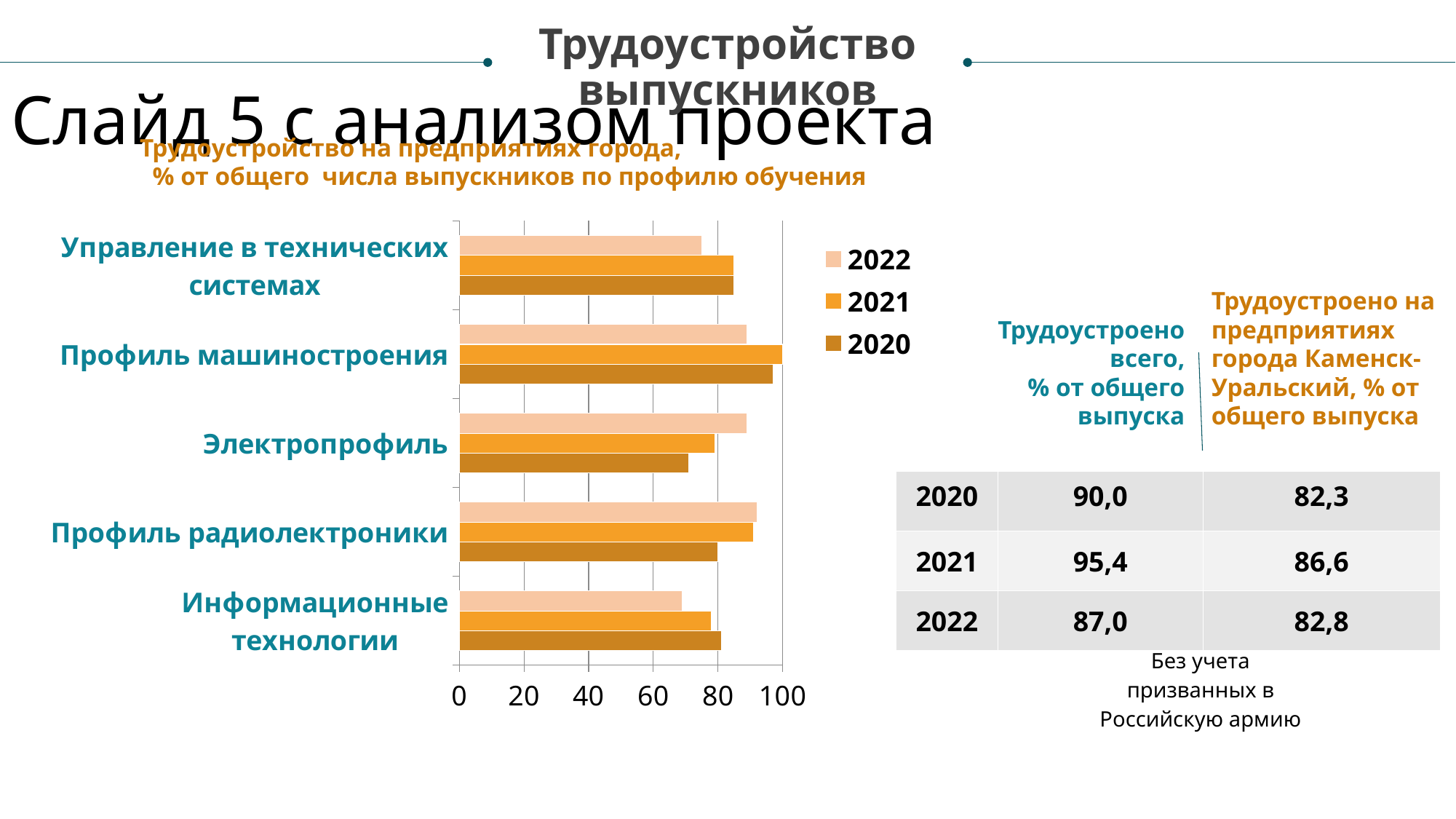
Is the 2021 value for Профиль машиностроения greater or less than 80? greater For Электропрофиль, which series has the larger value: 2022 or 2020? 2022 For Информационные технологии, which series has the larger value: 2020 or 2022? 2020 Is the 2022 value for Управление в технических системах greater or less than 80? less Which category has the lowest value for the 2022 series? Информационные технологии What kind of chart is shown on the slide? bar chart Which years are listed in the chart legend? 2022, 2021, 2020 Which category has the lowest value for the 2020 series? Электропрофиль How many categories (training profiles) does the chart show? 5 Which category has the highest value for the 2021 series? Профиль машиностроения Is the 2020 value for Электропрофиль greater or less than 80? less How many series does the chart legend list? 3